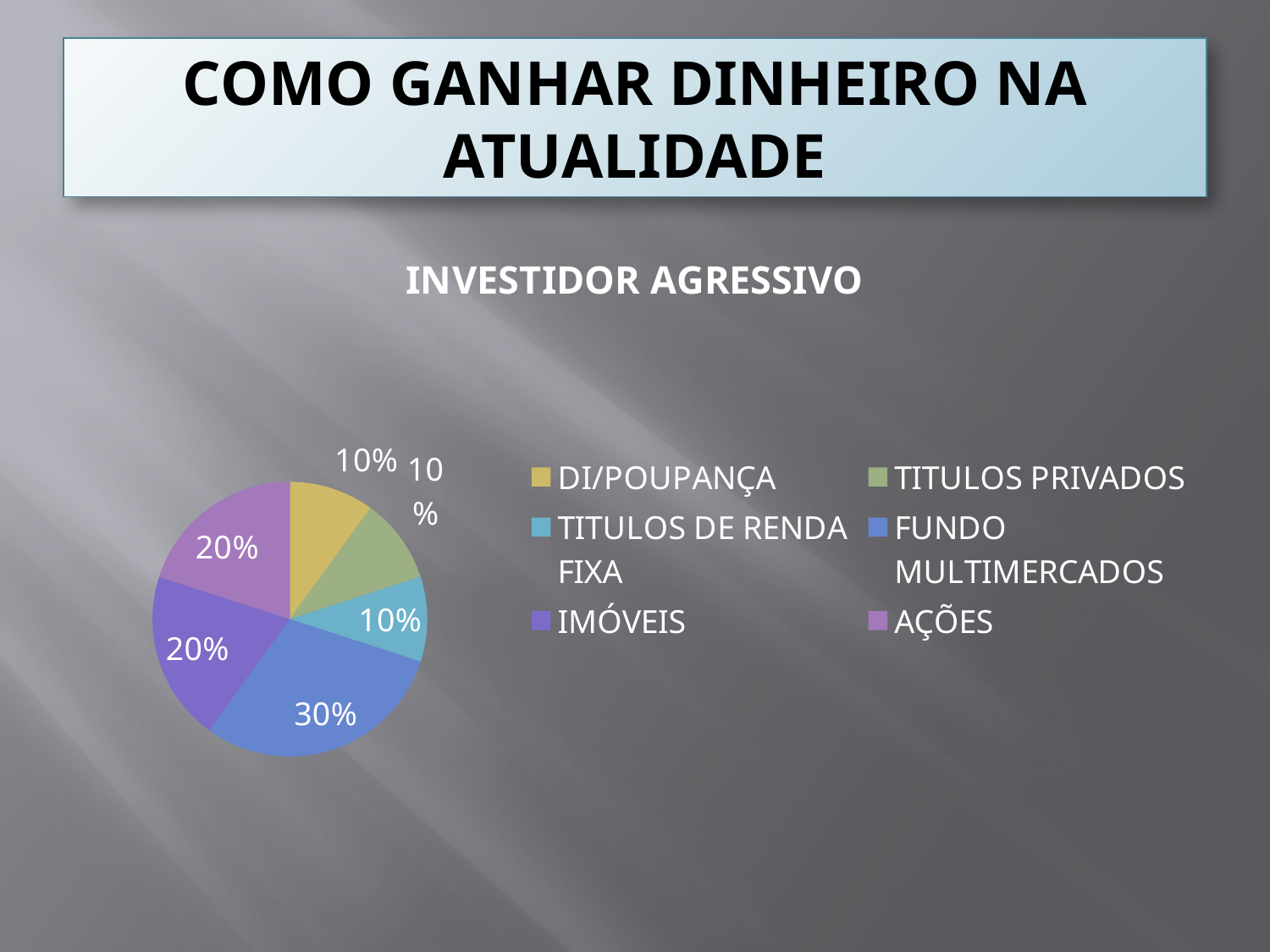
What share of the pie is AÇÕES? 20% What kind of chart is shown on the slide? pie chart Which is larger, the share for IMÓVEIS or the share for DI/POUPANÇA? IMÓVEIS How many slices does the pie chart have? 6 What is the difference between the shares of FUNDO MULTIMERCADOS and TITULOS PRIVADOS? 20% How many entries does the legend list? 6 What is the value for DI/POUPANÇA? 10% Which category has the largest slice of the pie? FUNDO MULTIMERCADOS What is the value for TITULOS DE RENDA FIXA? 10% What is the title of the chart? INVESTIDOR AGRESSIVO What share of the pie is IMÓVEIS? 20% What share of the pie is FUNDO MULTIMERCADOS? 30%